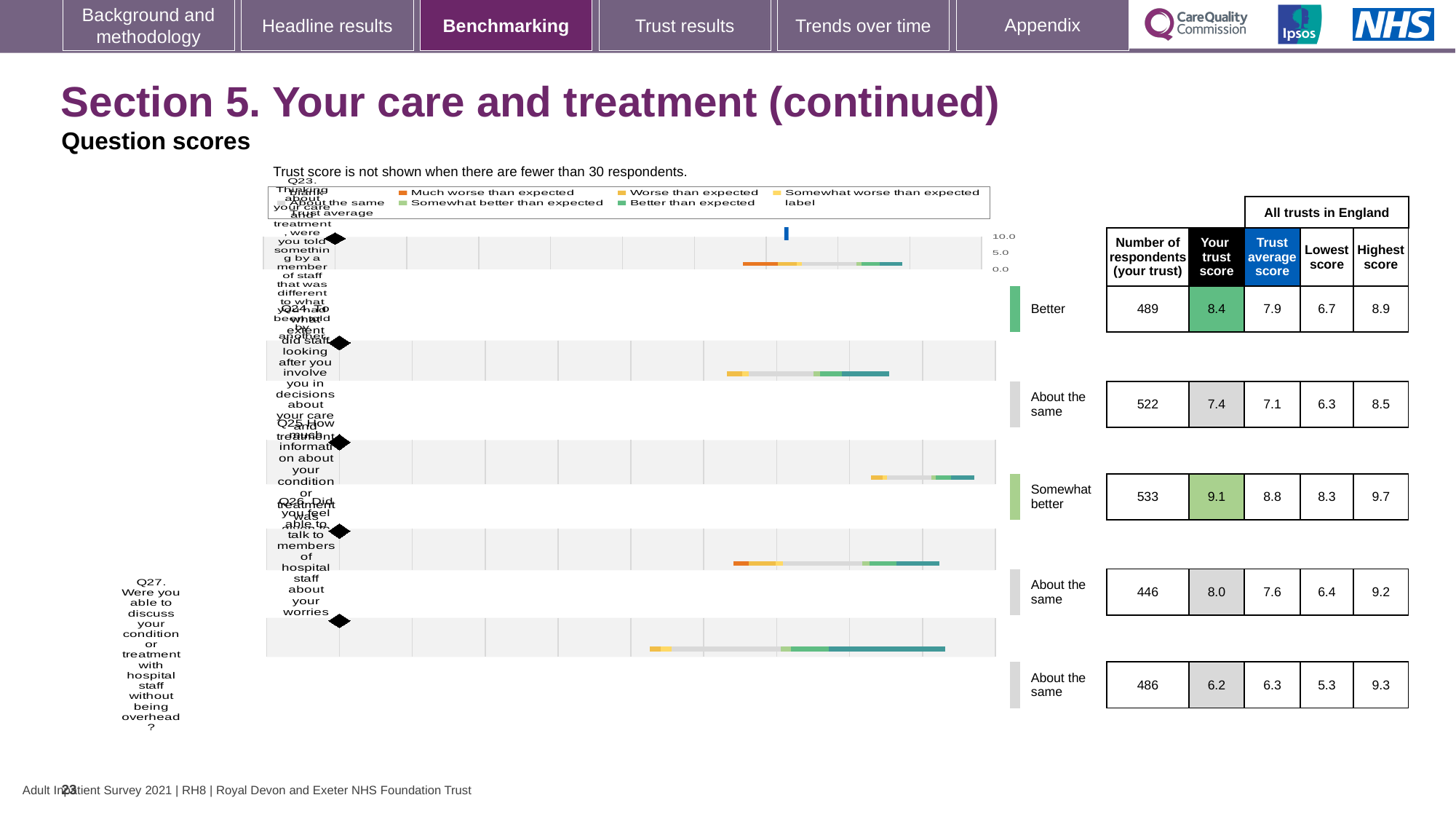
In the table beside the chart, which is larger for Q24: your trust score or the trust average score? Your trust score What kind of chart is used to show the question scores on this slide? bar chart According to the table beside the chart, which question has the lowest 'Your trust score'? Q27 How many questions (Q23 to Q27) are plotted as bars in the chart? 5 According to the table beside the chart, which question has the highest 'Your trust score'? Q25 In the table beside the chart, what is the highest score across all trusts in England for Q27? 9.3 Which legend entry in the chart is shown in orange? Much worse than expected In the table beside the chart, what is the difference between your trust score and the trust average score for Q23? 0.5 In the table beside the chart, what is your trust score for Q25 (how much information about your condition or treatment was given to you)? 9.1 What is the maximum value shown on the chart's score axis? 10.0 In the table beside the chart, how many respondents answered Q23 for your trust? 489 What benchmark category is shown for Q23 next to the chart? Better